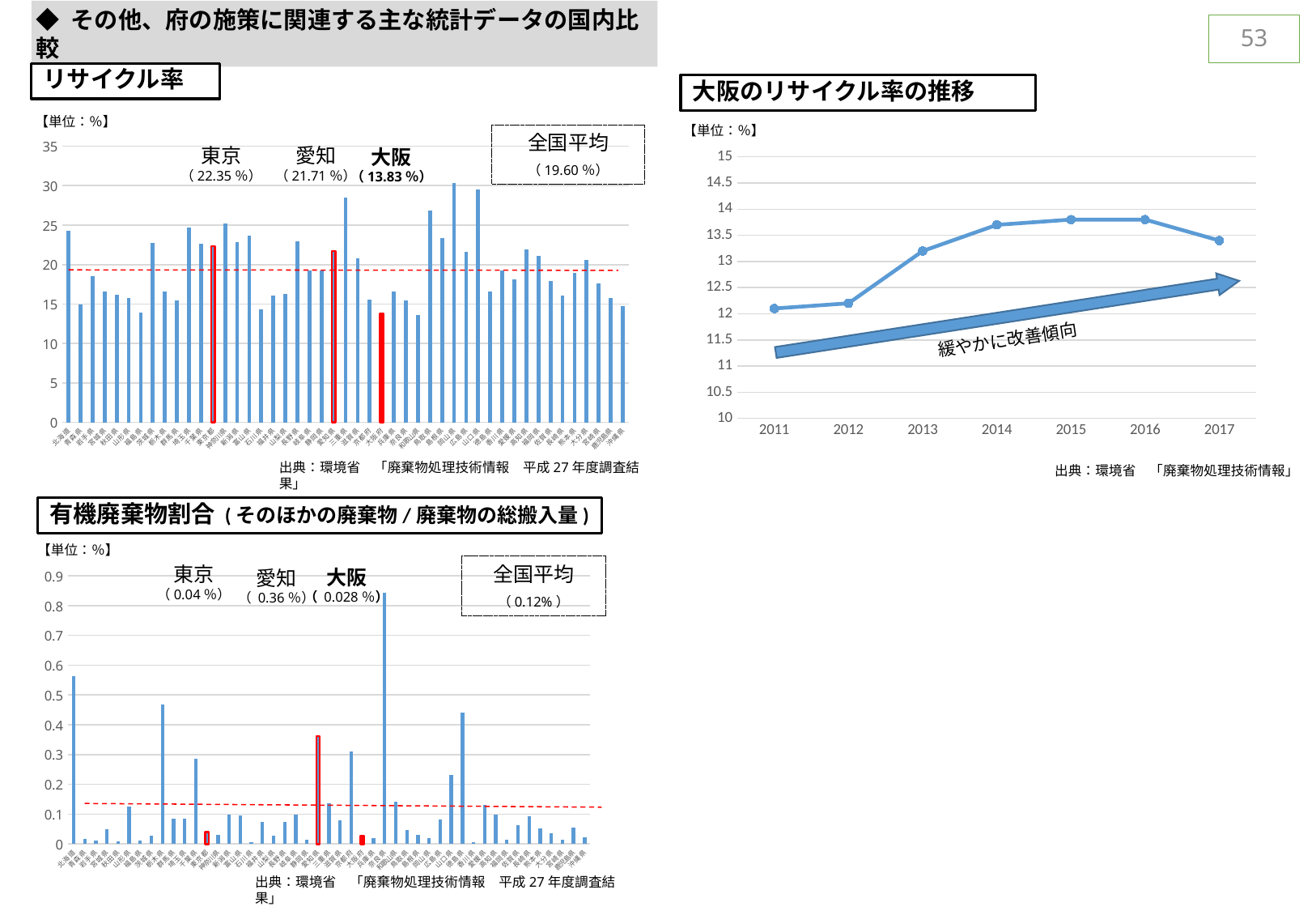
In the 有機廃棄物割合 chart, which is larger, the value for 愛知 or the 全国平均? 愛知 In the リサイクル率 chart, what is the 全国平均 (national average) value? 19.60 % In the 大阪のリサイクル率の推移 chart, how many data points are plotted? 7 In the 大阪のリサイクル率の推移 chart, is the value for 2015 greater or less than 13.5? greater In the 大阪のリサイクル率の推移 chart, is the value for 2011 greater or less than 12.5? less In the リサイクル率 chart, what is the recycling rate for 大阪? 13.83 % In the 有機廃棄物割合 chart, what is the value for 大阪? 0.028 % In the リサイクル率 chart, what is the recycling rate for 東京? 22.35 % In the リサイクル率 chart, which has the higher recycling rate, 東京 or 大阪? 東京 What kind of chart is the リサイクル率 chart? Bar chart In the リサイクル率 chart, what is the difference between the recycling rates of 東京 and 大阪? 8.52 % In the 有機廃棄物割合 chart, what is the value for 愛知? 0.36 %